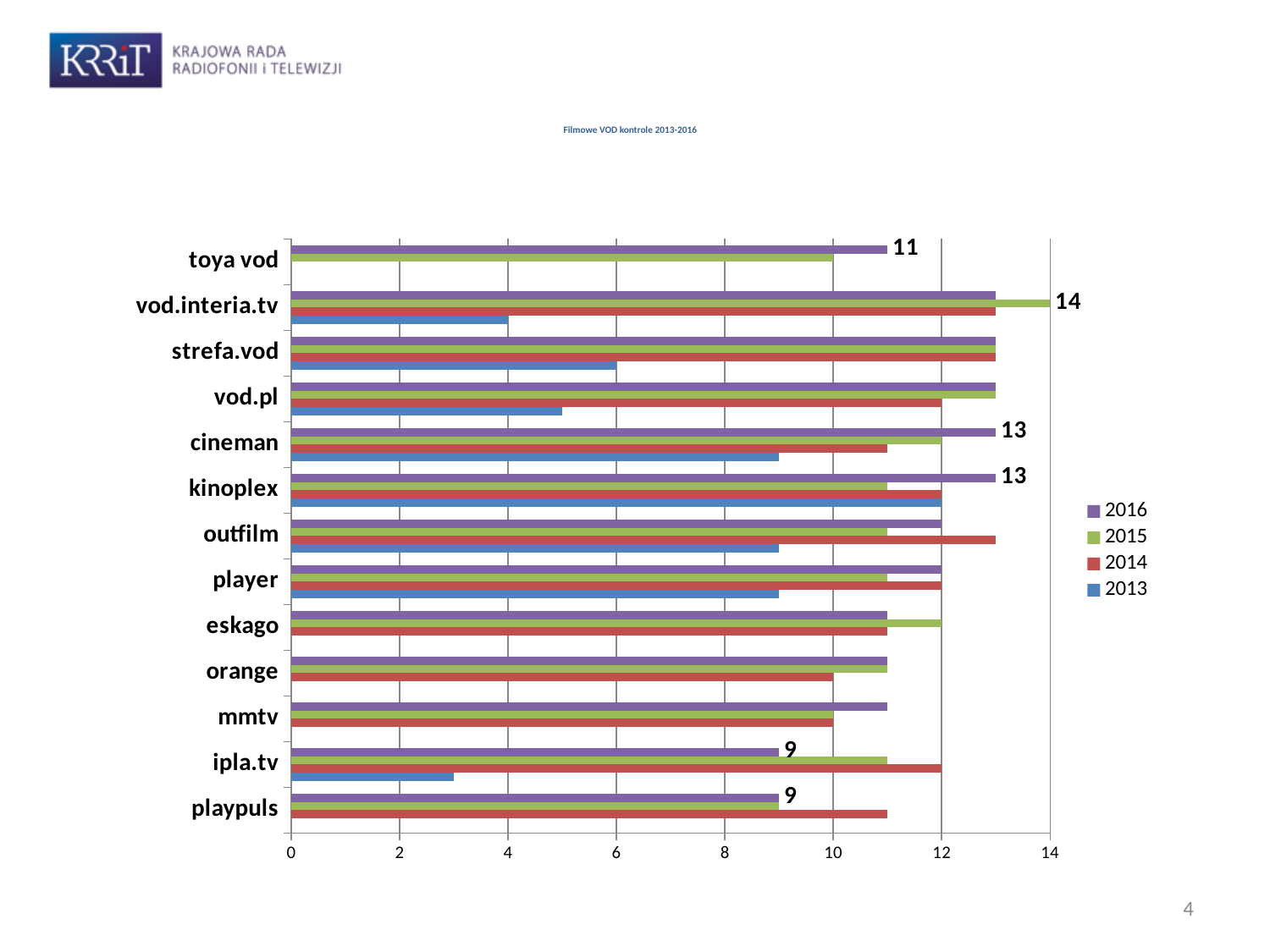
Is the 2013 value for ipla.tv greater or less than 4? less How many series does the legend list? 4 What is the 2016 value for ipla.tv? 9 What is the 2013 value for vod.interia.tv? 4 What is the difference between the 2016 values for kinoplex and playpuls? 4 What is the 2016 value for toya vod? 11 How many categories (VOD services) are shown on the chart? 13 What is the 2016 value for cineman? 13 What is the title of the chart? Filmowe VOD kontrole 2013-2016 What kind of chart is shown on the slide? bar chart What is the 2015 value for vod.interia.tv? 14 Which is larger: the 2016 value for cineman or the 2016 value for ipla.tv? cineman